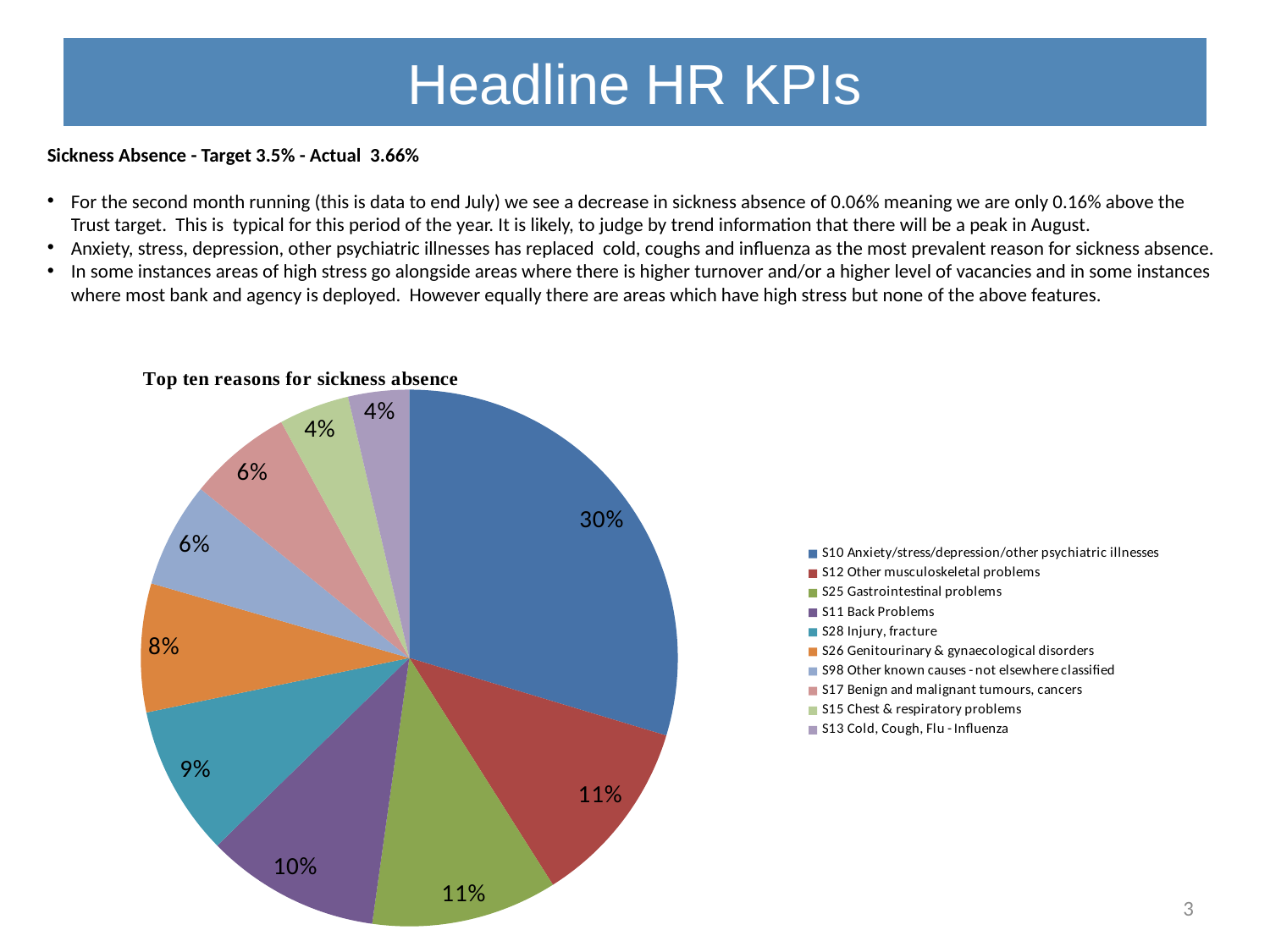
What share of sickness absence is attributed to S13 Cold, Cough, Flu - Influenza? 4% What is the difference in share between S10 Anxiety/stress/depression/other psychiatric illnesses and S12 Other musculoskeletal problems? 19% What share of sickness absence is attributed to S26 Genitourinary & gynaecological disorders? 8% Which has the larger share: S11 Back Problems or S26 Genitourinary & gynaecological disorders? S11 Back Problems What share of sickness absence is attributed to S10 Anxiety/stress/depression/other psychiatric illnesses? 30% What share of sickness absence is attributed to S11 Back Problems? 10% What share of sickness absence is attributed to S28 Injury, fracture? 9% What kind of chart is shown on the slide? pie chart How many slices does the pie chart have? 10 Which reason accounts for the largest share of sickness absence? S10 Anxiety/stress/depression/other psychiatric illnesses How many entries does the legend list? 10 What is the title of the chart? Top ten reasons for sickness absence